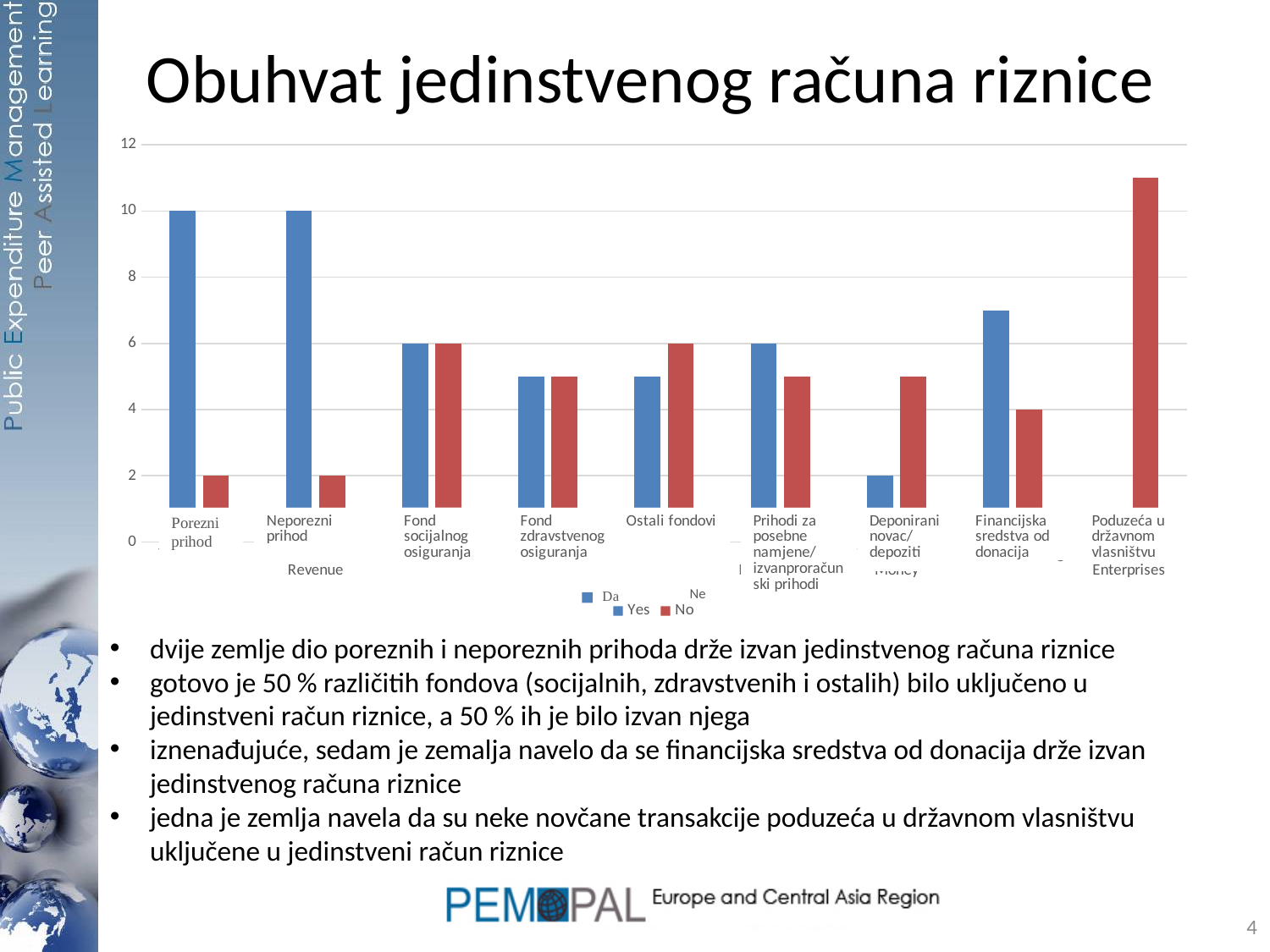
What is the value of the 'Da' (Yes) bar for 'Deponirani novac/depoziti'? 2 How many series does the chart's legend list? 2 What is the value of the 'Da' (Yes) bar for 'Porezni prihod'? 10 How many categories are shown along the x axis of the chart? 9 What is the value of the 'Ne' (No) bar for 'Financijska sredstva od donacija'? 4 What is the difference between the 'Da' and 'Ne' bars for 'Porezni prihod'? 8 For 'Financijska sredstva od donacija', which bar is larger, 'Da' or 'Ne'? Da What is the value of the 'Ne' (No) bar for 'Neporezni prihod'? 2 Which category has the highest 'Ne' (No) value? Poduzeća u državnom vlasništvu Is the 'Ne' (No) value for 'Poduzeća u državnom vlasništvu' greater or less than 10? greater Which colour represents the 'Ne' (No) series in the chart? red What type of chart is shown on the slide? bar chart